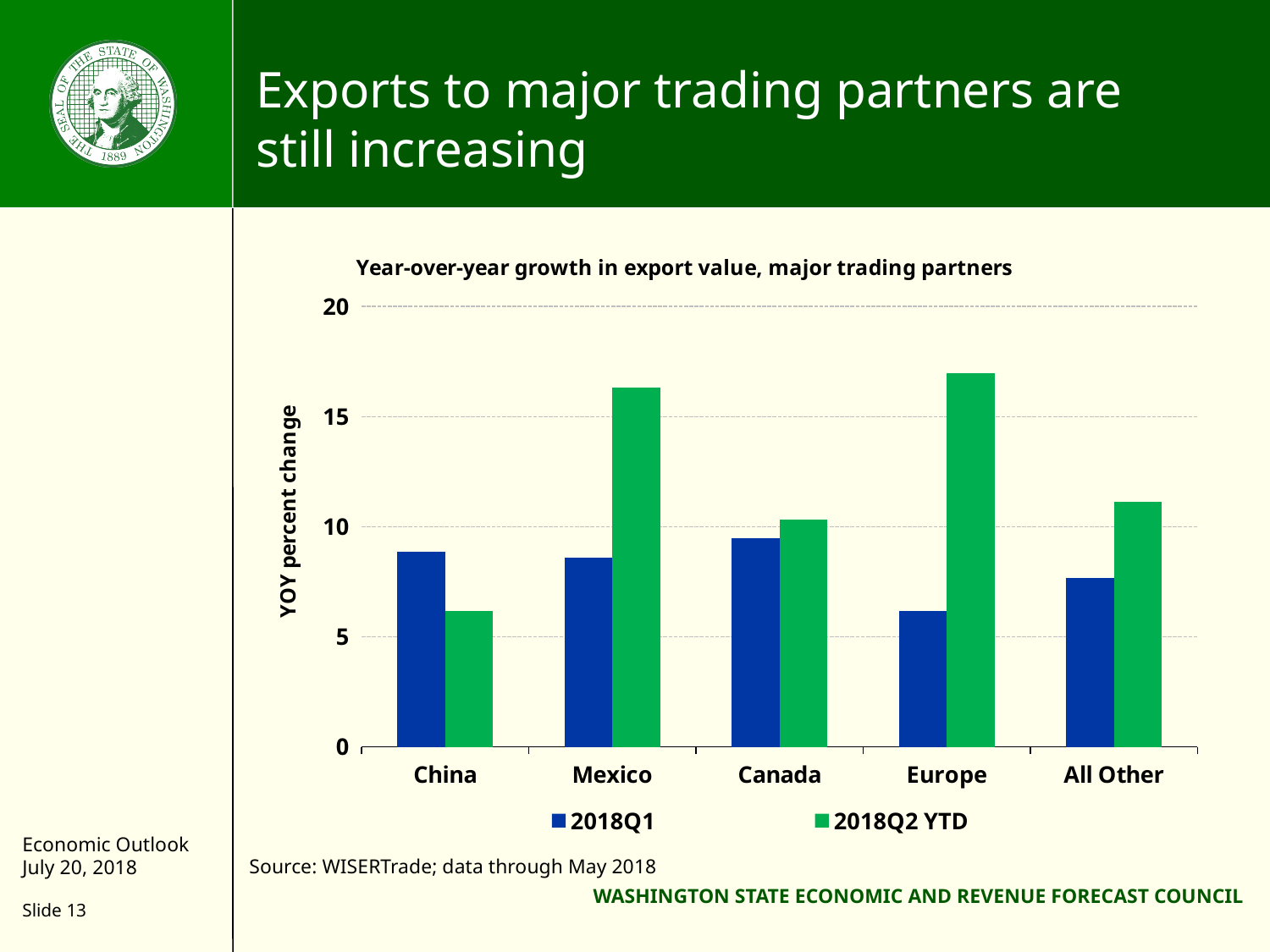
How many trading partner categories are shown on the x axis? 5 How many series does the legend list? 2 Is the 2018Q1 value for Canada greater or less than 10? less Which category has the lowest 2018Q2 YTD value? China Which category has the lowest 2018Q1 value? Europe What kind of chart is shown on the slide? bar chart What is the title of the chart? Year-over-year growth in export value, major trading partners What is the label on the y axis of the chart? YOY percent change Is the 2018Q2 YTD value for Europe greater or less than 15? greater Is the 2018Q2 YTD value for All Other greater or less than 10? greater For China, which is larger: the 2018Q1 value or the 2018Q2 YTD value? 2018Q1 For Mexico, which is larger: the 2018Q1 value or the 2018Q2 YTD value? 2018Q2 YTD